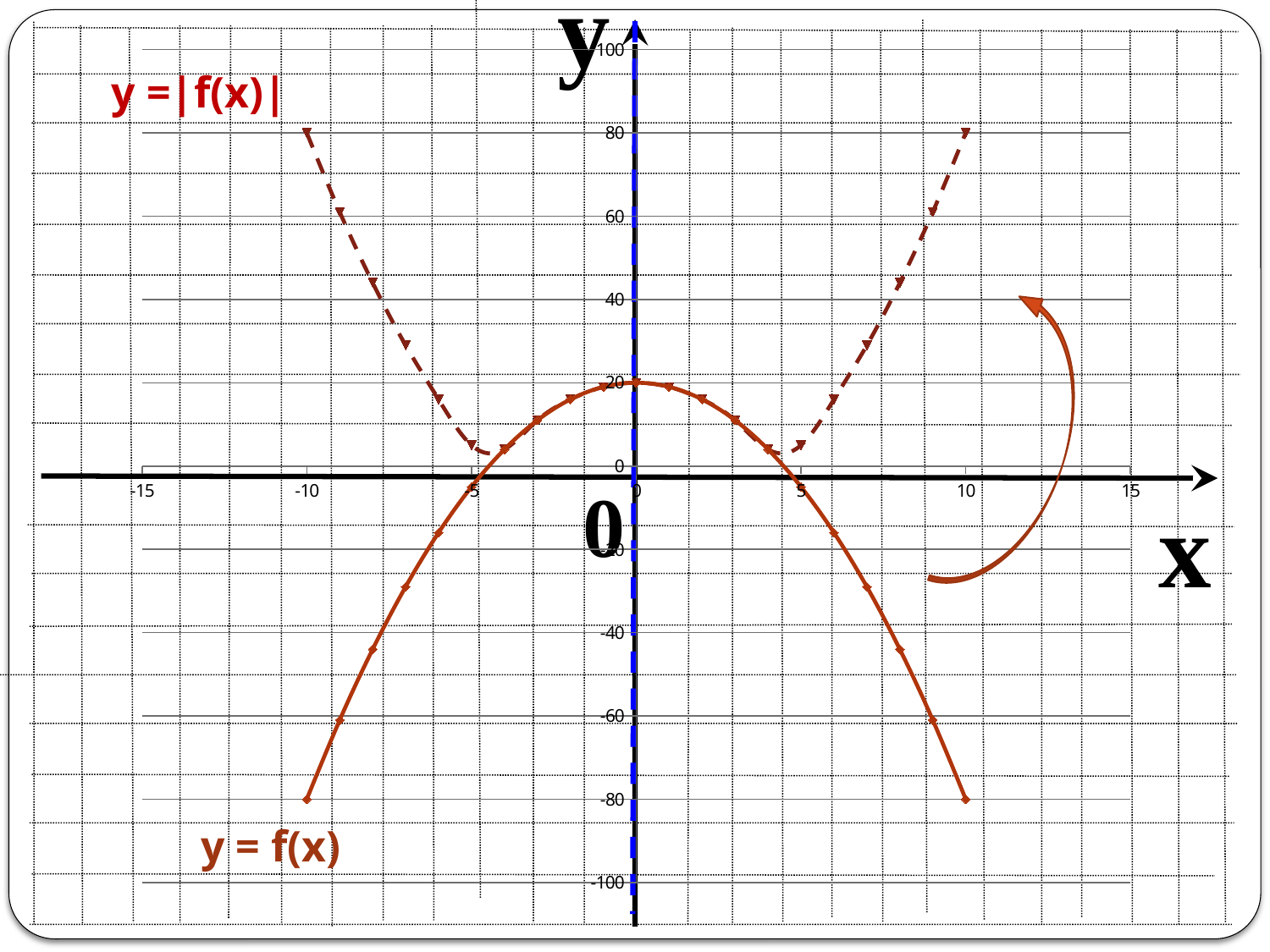
What is the difference between y = |f(x)| and y = f(x) at x = 10? 160 At x = 10, which curve has the larger value, y = f(x) or y = |f(x)|? y = |f(x)| What is the value of y = |f(x)| at x = 10? 80 At which x value does the curve y = f(x) reach its highest point? 0 How many curves are plotted on the chart? 2 What is the value of y = f(x) at x = 10? -80 Does the curve y = f(x) rise or fall as x goes from 0 to 10? fall What is the lowest plotted value of y = f(x)? -80 Which curve is drawn with a dashed line? y = |f(x)| Is the value of y = f(x) at x = 7 greater or less than 0? less What is the value of y = f(x) at x = 0? 20 What kind of chart is shown on the slide? line chart